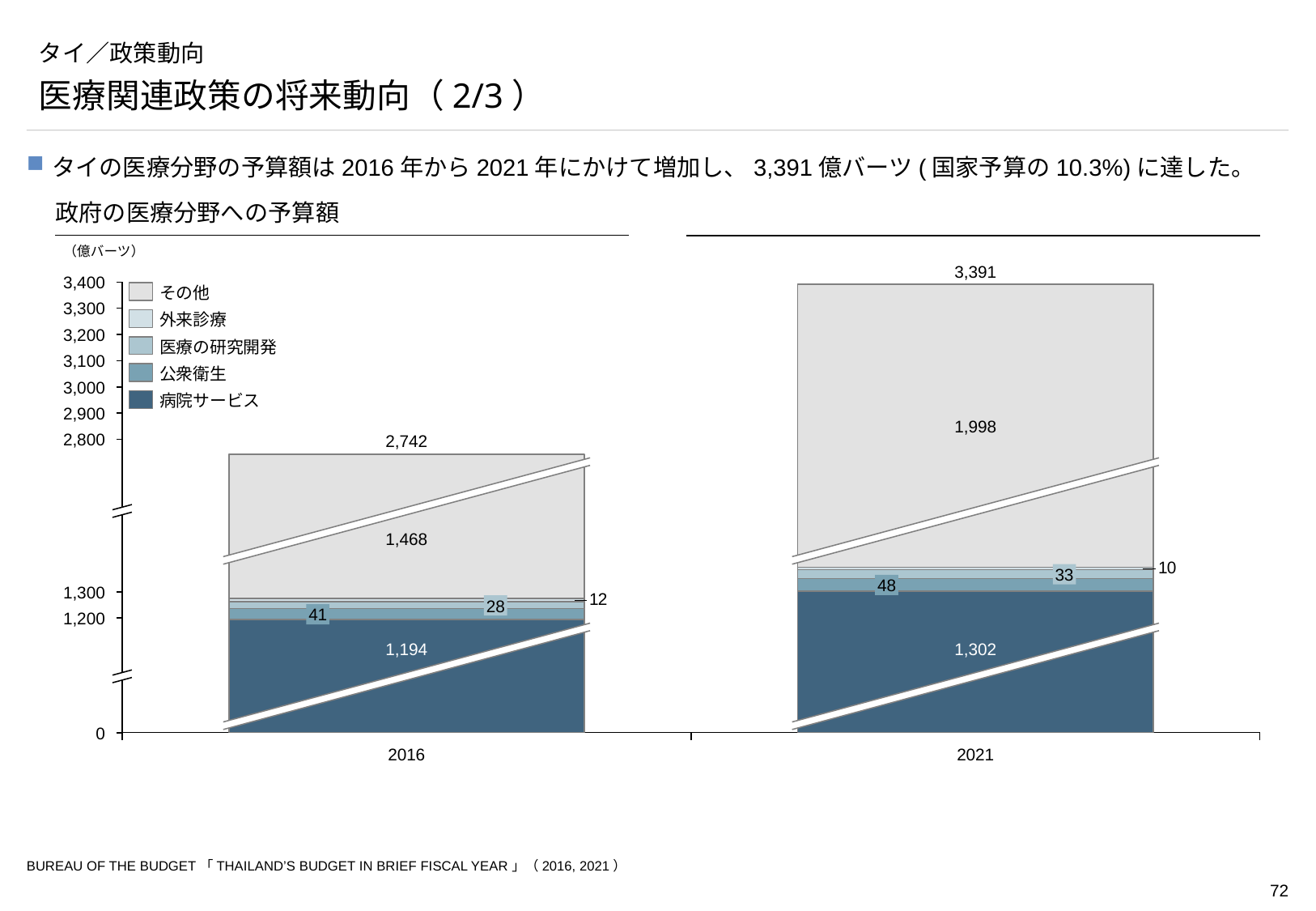
What is the value of 公衆衛生 in 2021? 48 What is the difference in 病院サービス between 2021 and 2016? 108 What is the total value of the stacked bar for 2021? 3,391 What is the value of 病院サービス in 2016? 1,194 By how much did the total budget increase from 2016 to 2021? 649 What is the total value of the stacked bar for 2016? 2,742 How many series does the legend list? 5 What is the value of 外来診療 in 2016? 12 What is the value of その他 in 2021? 1,998 Which year has the larger value for 医療の研究開発, 2016 or 2021? 2021 How many years are shown on the x axis? 2 What kind of chart is shown on the slide? Stacked bar chart